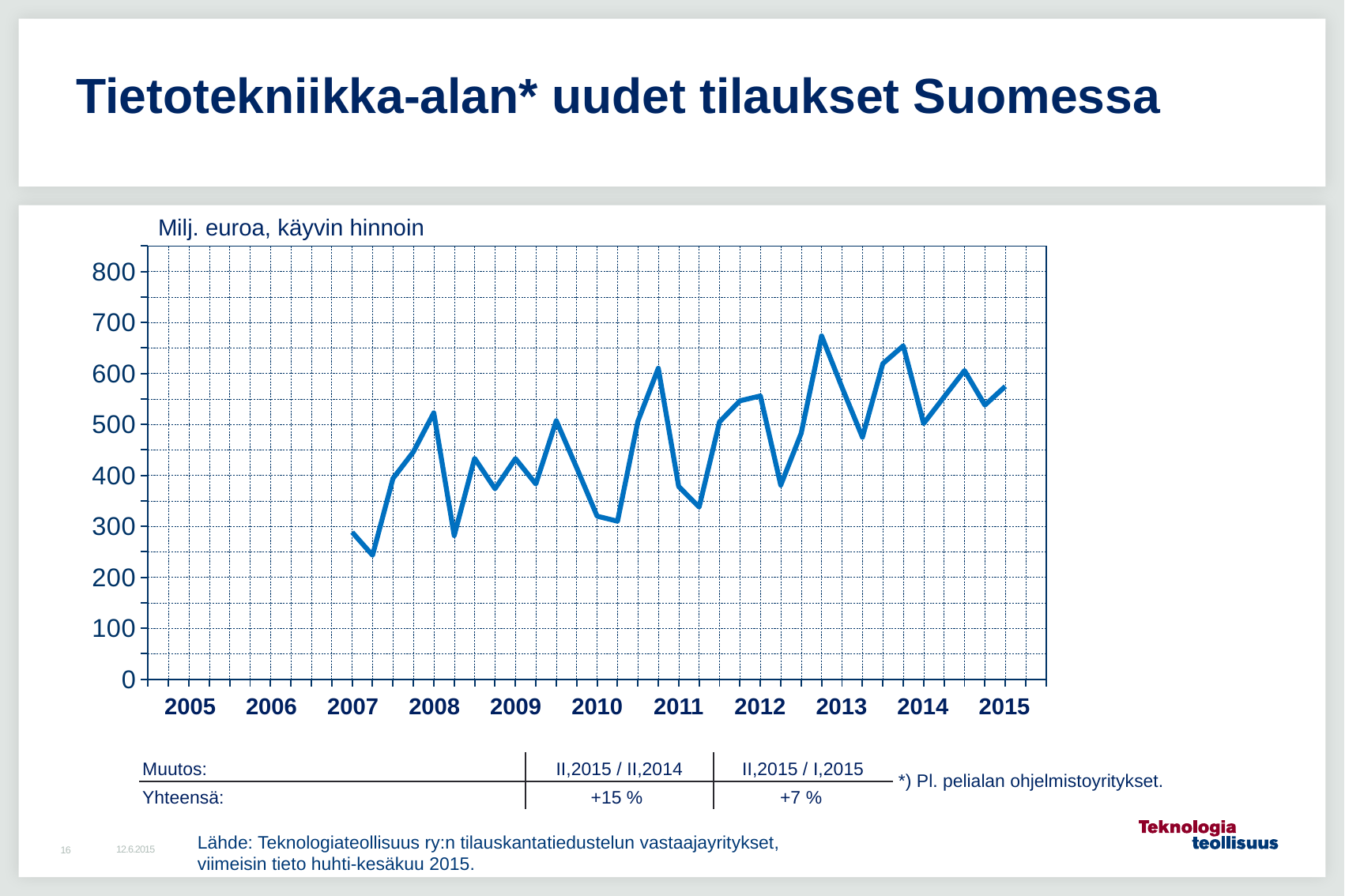
In which year does the line reach its lowest point? 2007 What is the title of the slide's chart? Tietotekniikka-alan* uudet tilaukset Suomessa Is the value at the 2015 tick greater or less than 500? greater Is the highest point of the line greater or less than 600? greater Is the value at the 2012 tick greater or less than 500? greater What kind of chart is shown on the slide? line chart What unit label is shown above the y axis of the chart? Milj. euroa, käyvin hinnoin How many year labels are shown on the x axis of the chart? 11 Overall, does the line rise or fall from 2007 to 2015? rise How many lines are plotted on the chart? 1